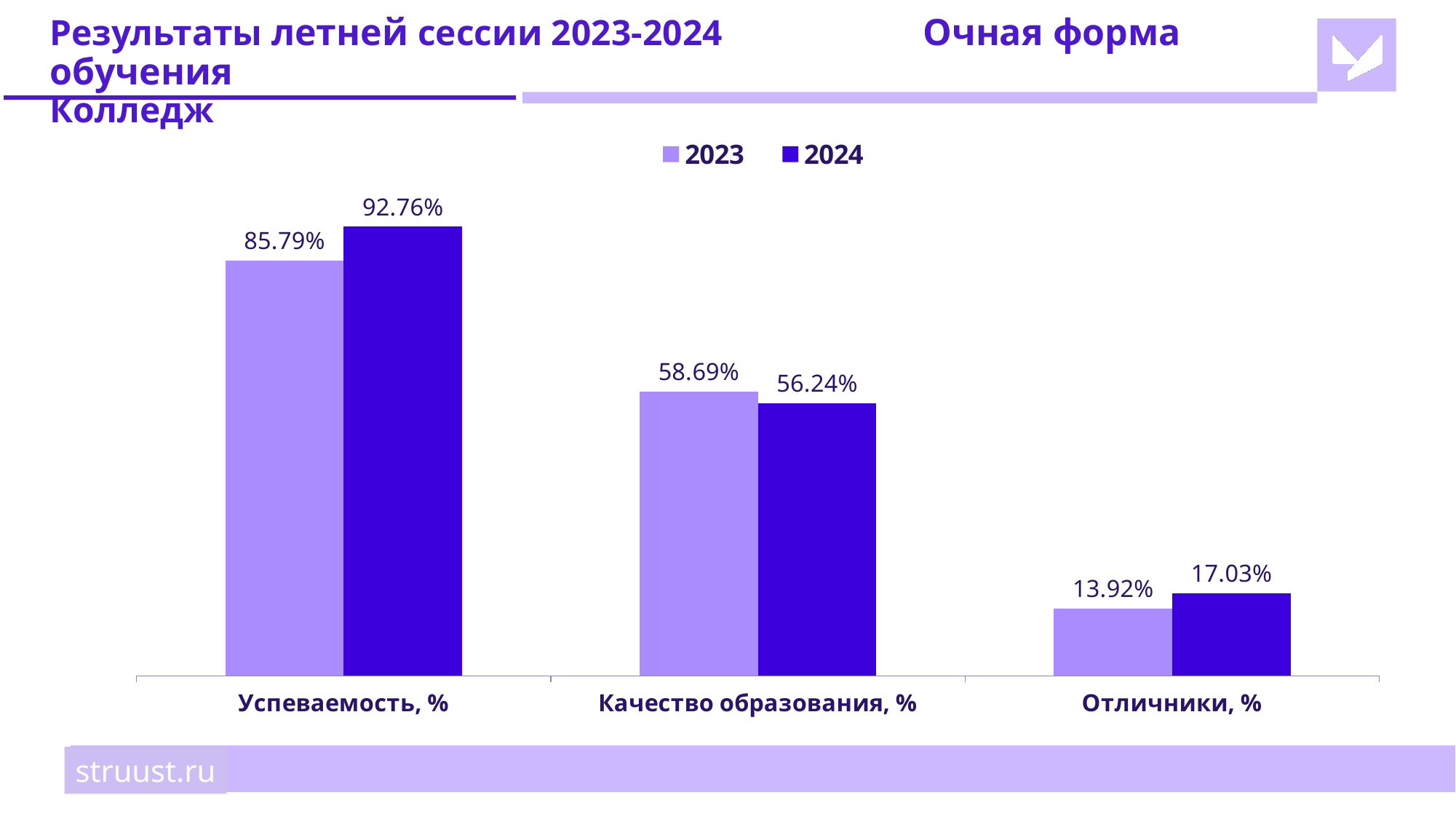
Which category has the highest 2024 value? Успеваемость, % Which category has the lowest 2023 value? Отличники, % What is the 2024 value for Качество образования, %? 56.24% What kind of chart is shown on the slide? Bar chart What is the difference between the 2024 and 2023 values for Успеваемость, %? 6.97% What is the 2023 value for Отличники, %? 13.92% Which series is shown in the darker purple colour? 2024 How many categories are shown on the x axis? 3 How many series does the legend list? 2 What is the 2023 value for Качество образования, %? 58.69% What is the 2024 value for Успеваемость, %? 92.76% For Качество образования, %, which year has the larger value, 2023 or 2024? 2023